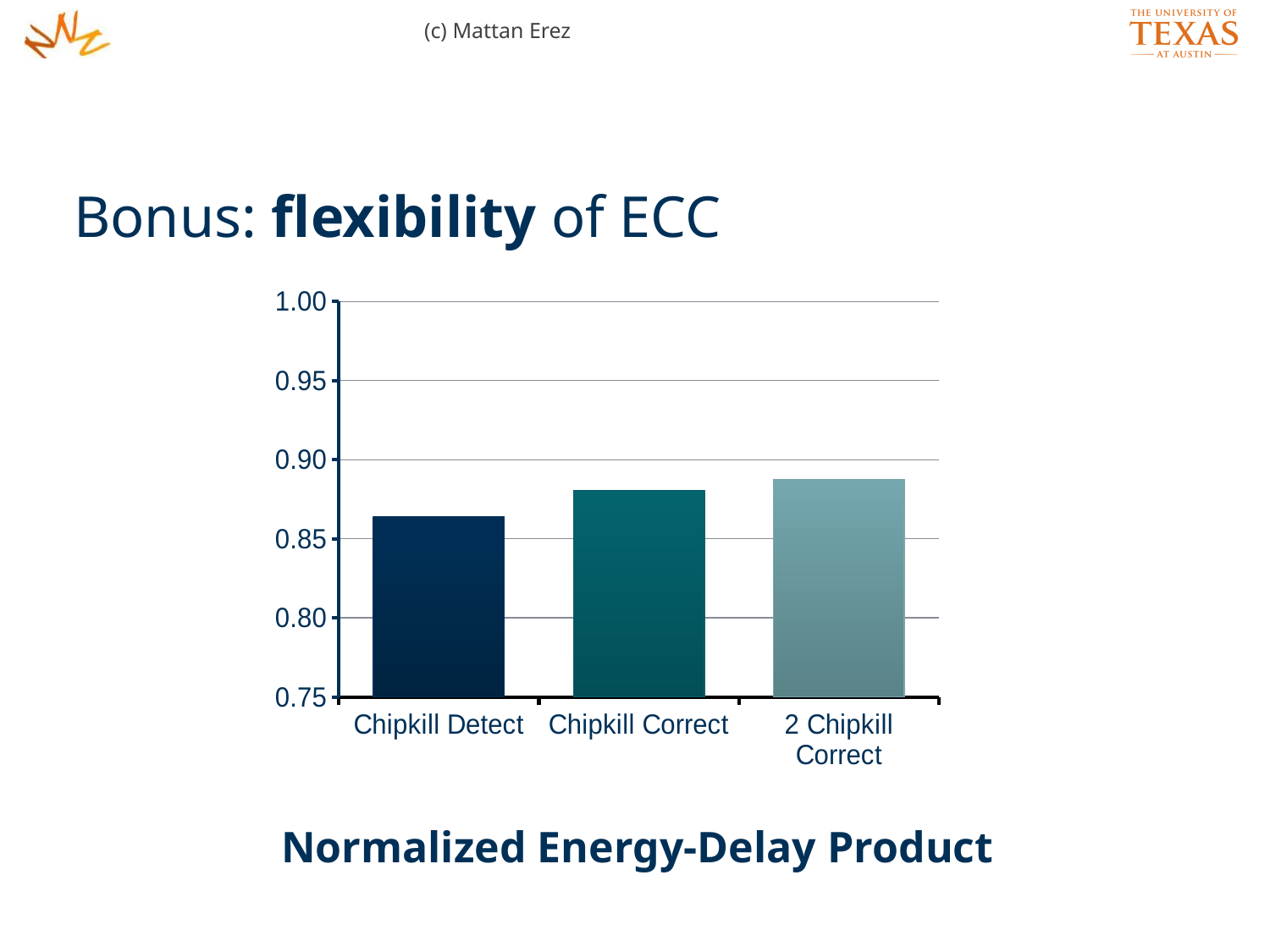
Is the value for Chipkill Detect greater or less than 0.85? greater Is the value for 2 Chipkill Correct greater or less than 0.90? less Which category has the lowest Normalized Energy-Delay Product? Chipkill Detect What kind of chart is shown on the slide? bar chart Which is larger, the value for Chipkill Detect or the value for Chipkill Correct? Chipkill Correct Is the value for Chipkill Correct greater or less than 0.90? less What is the lowest value shown on the y axis? 0.75 Do the values rise or fall from left to right across the categories? rise How many categories are plotted in the chart? 3 What quantity does the chart plot, according to the caption below it? Normalized Energy-Delay Product